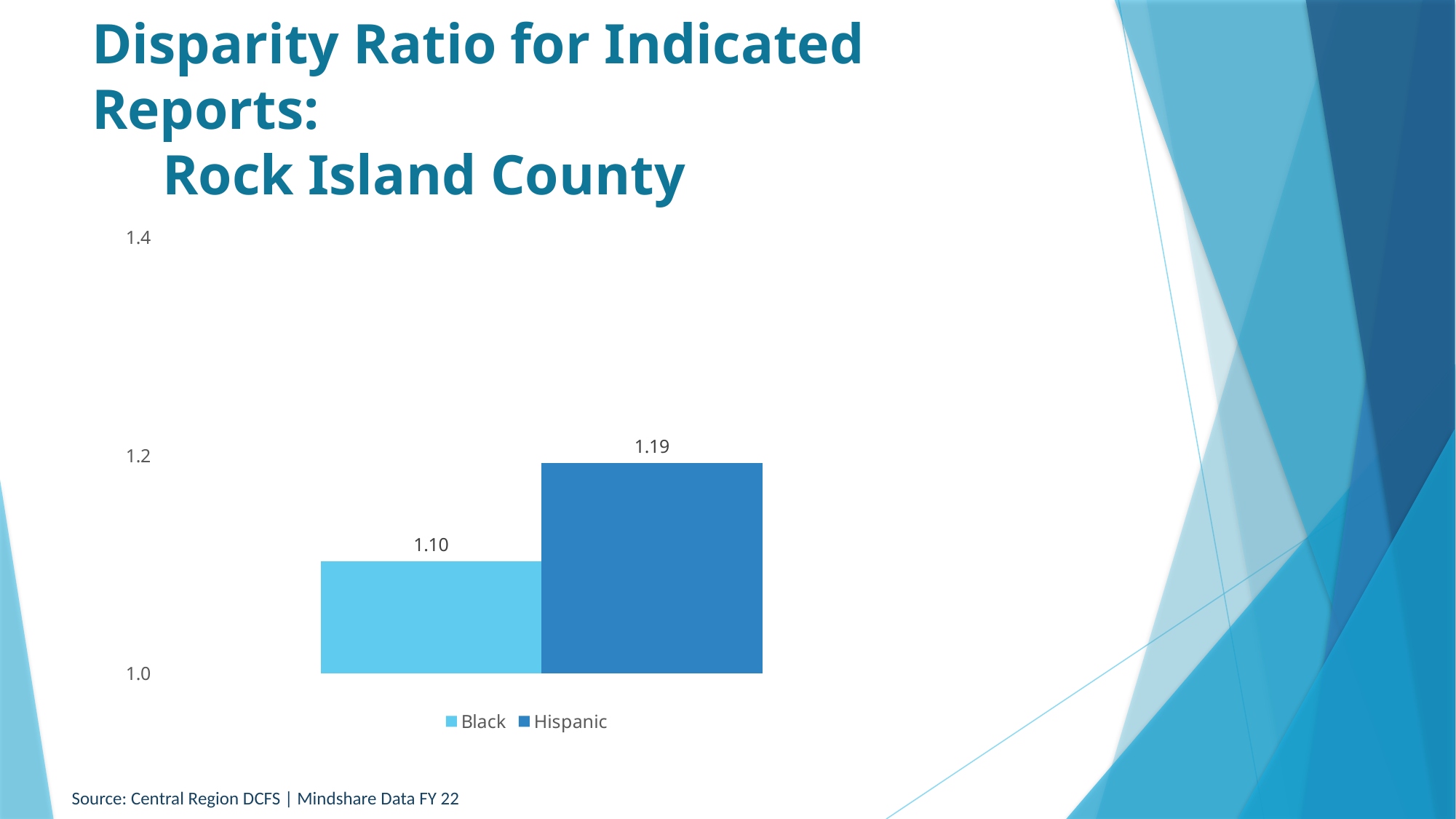
What is the highest value shown on the vertical axis? 1.4 Is the disparity ratio for Black larger or smaller than the ratio for Hispanic? smaller Is the value for Black greater or less than 1.0? greater How many bars are plotted in the chart? 2 What is the disparity ratio for Black? 1.10 Which group has the higher disparity ratio? Hispanic How many series does the legend list? 2 What kind of chart is shown on the slide? bar chart What is the difference between the Hispanic and Black disparity ratios? 0.09 What is the disparity ratio for Hispanic? 1.19 Which group has the lower disparity ratio? Black Is the value for Hispanic greater or less than 1.2? less